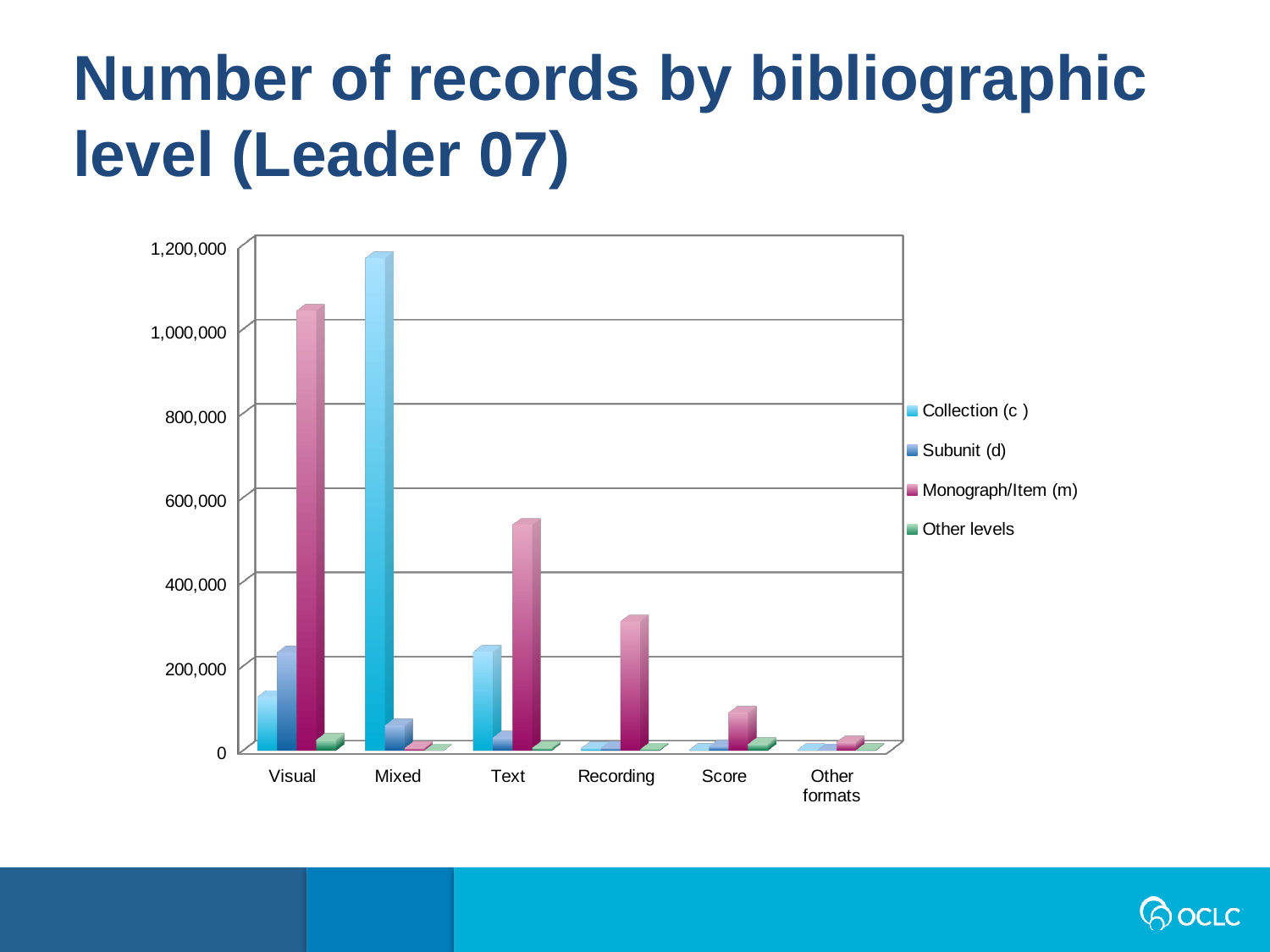
What kind of chart is shown on the slide? bar chart For Visual, which is larger: the Collection (c ) bar or the Subunit (d) bar? Subunit (d) How many series does the legend list? 4 Is the Monograph/Item (m) value for Text greater or less than 400,000? greater Which category has the highest Monograph/Item (m) bar? Visual How many categories are shown on the x axis? 6 For Text, which is larger: the Collection (c ) bar or the Monograph/Item (m) bar? Monograph/Item (m) Is the Collection (c ) value for Mixed greater or less than 1,000,000? greater Is the Monograph/Item (m) value for Recording greater or less than 400,000? less What is the title of the slide containing the chart? Number of records by bibliographic level (Leader 07) Which category has the highest Collection (c ) bar? Mixed